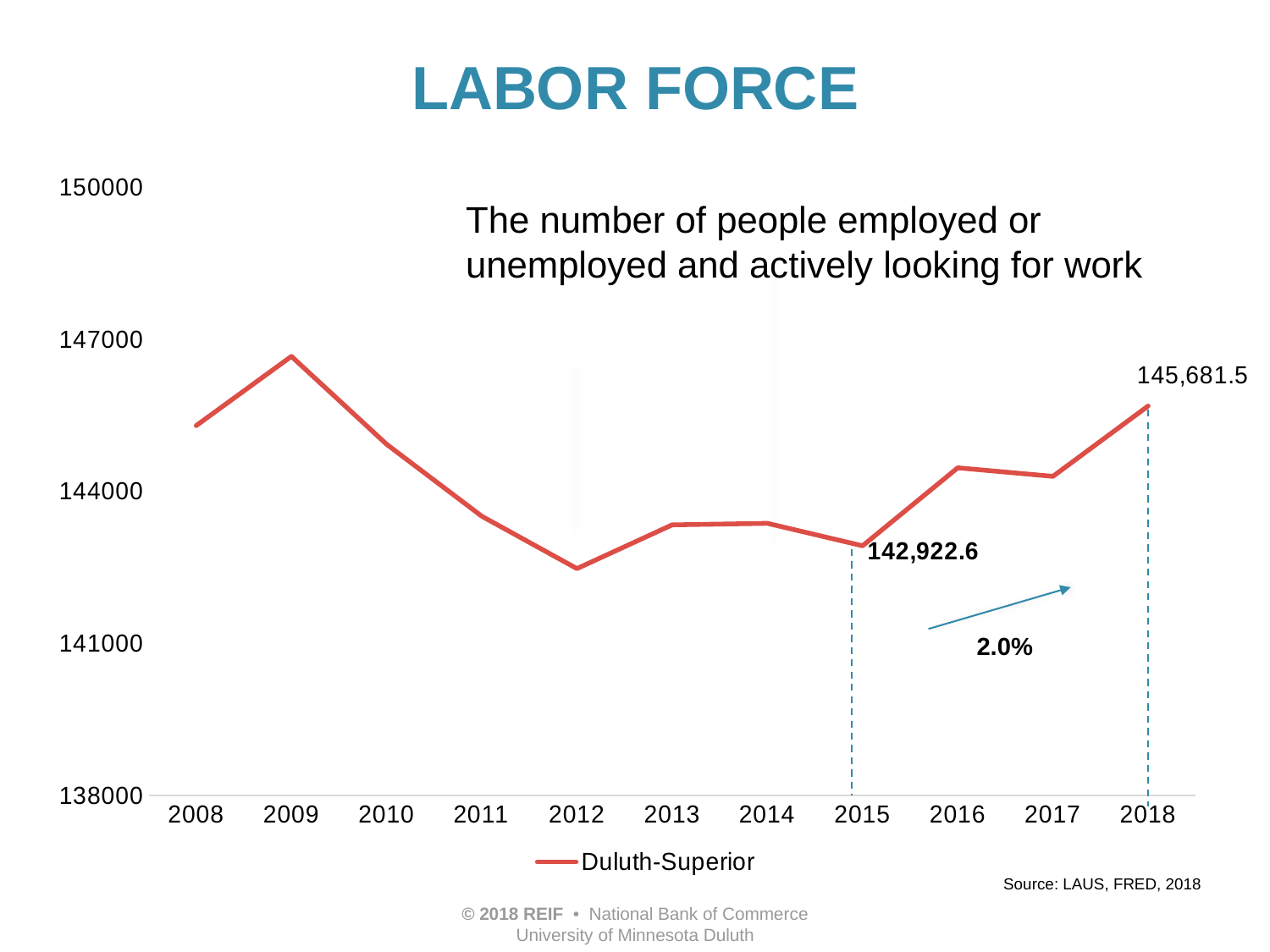
Is the value for 2009 greater or less than 144000? greater What is the difference between the 2018 value and the 2015 value? 2,758.9 How many years are plotted on the x axis? 11 What is the labor force value shown for 2015? 142,922.6 Is the value for 2012 greater or less than 144000? less What kind of chart is shown on the slide? line chart Which year has the larger labor force, 2009 or 2018? 2009 In which year is the labor force lowest? 2012 In which year is the labor force highest? 2009 What is the labor force value shown for 2018? 145,681.5 Does the labor force rise or fall from 2015 to 2018? rise How many series does the legend list? 1